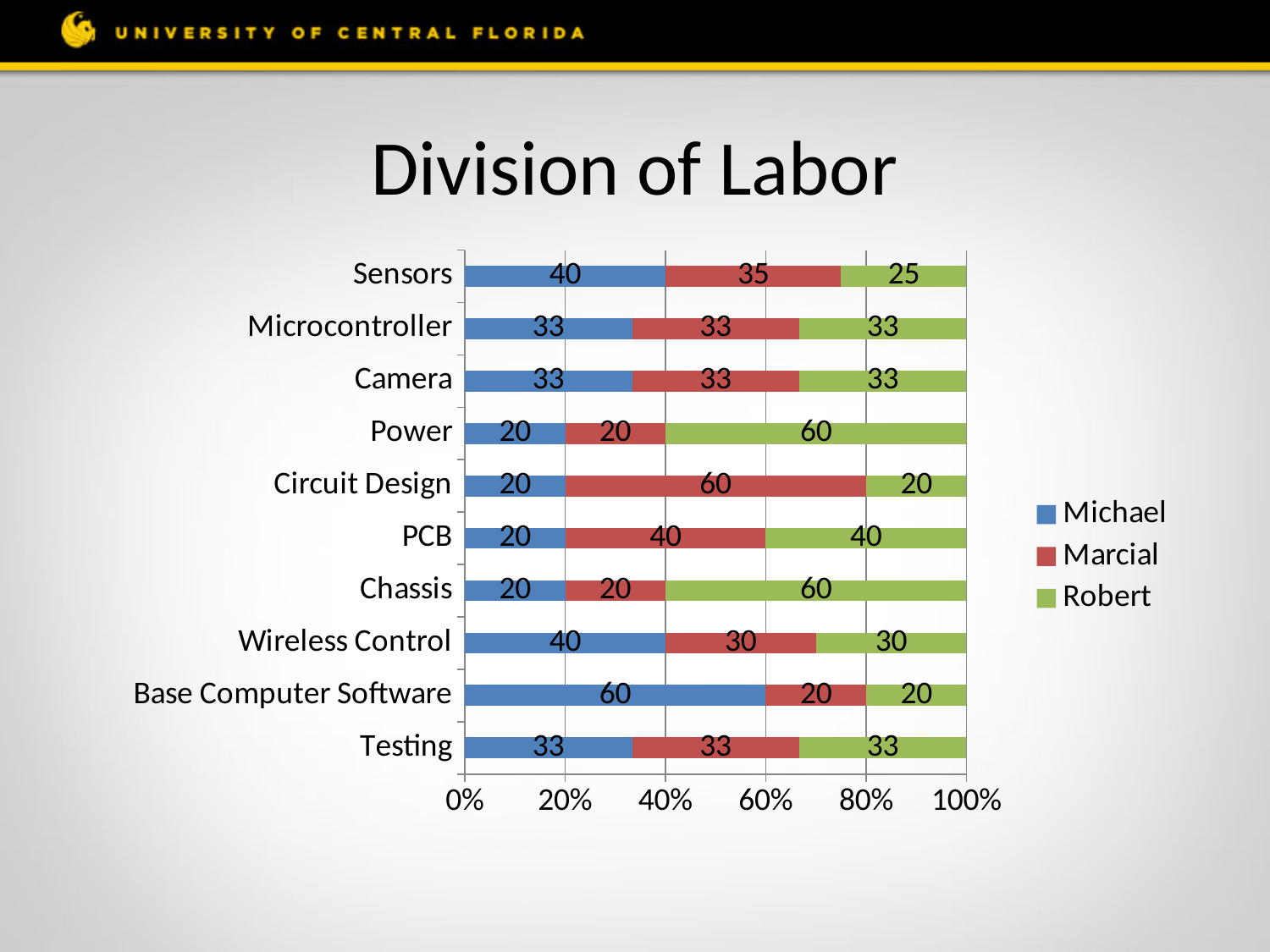
What is the value for Michael on Sensors? 40 What is the title of the chart? Division of Labor Which is larger on Wireless Control: Michael's value or Marcial's value? Michael What is the value for Robert on Power? 60 Which category has the lowest value for Robert? Circuit Design and Base Computer Software What is the difference between Marcial's value and Robert's value on Sensors? 10 What is the value for Michael on Base Computer Software? 60 What kind of chart is shown? Stacked bar chart How many series does the legend list? 3 How many categories are shown on the y axis? 10 What is the value for Marcial on Circuit Design? 60 Which category has the highest value for Michael? Base Computer Software